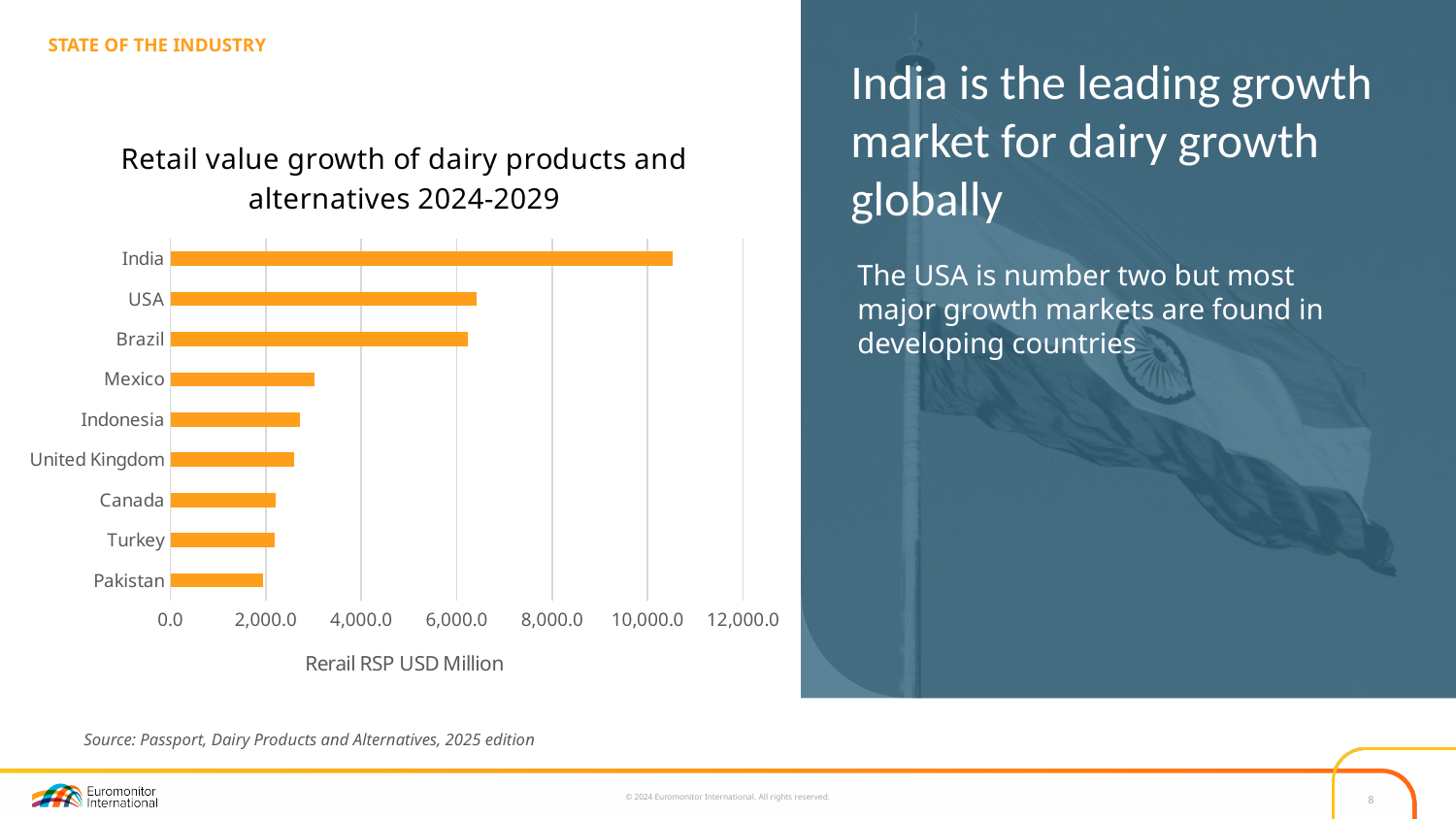
Which country has the highest retail value growth in the chart? India Is the value for Canada greater or less than 4,000.0? less Which country has the lowest retail value growth in the chart? Pakistan Is the value for USA greater or less than 8,000.0? less Is the value for Brazil greater or less than 4,000.0? greater What is the label on the horizontal axis of the chart? Rerail RSP USD Million Which has the larger value, Mexico or Pakistan? Mexico Which has the larger value, India or USA? India How many countries are shown in the chart? 9 What kind of chart is shown on the slide? Bar chart